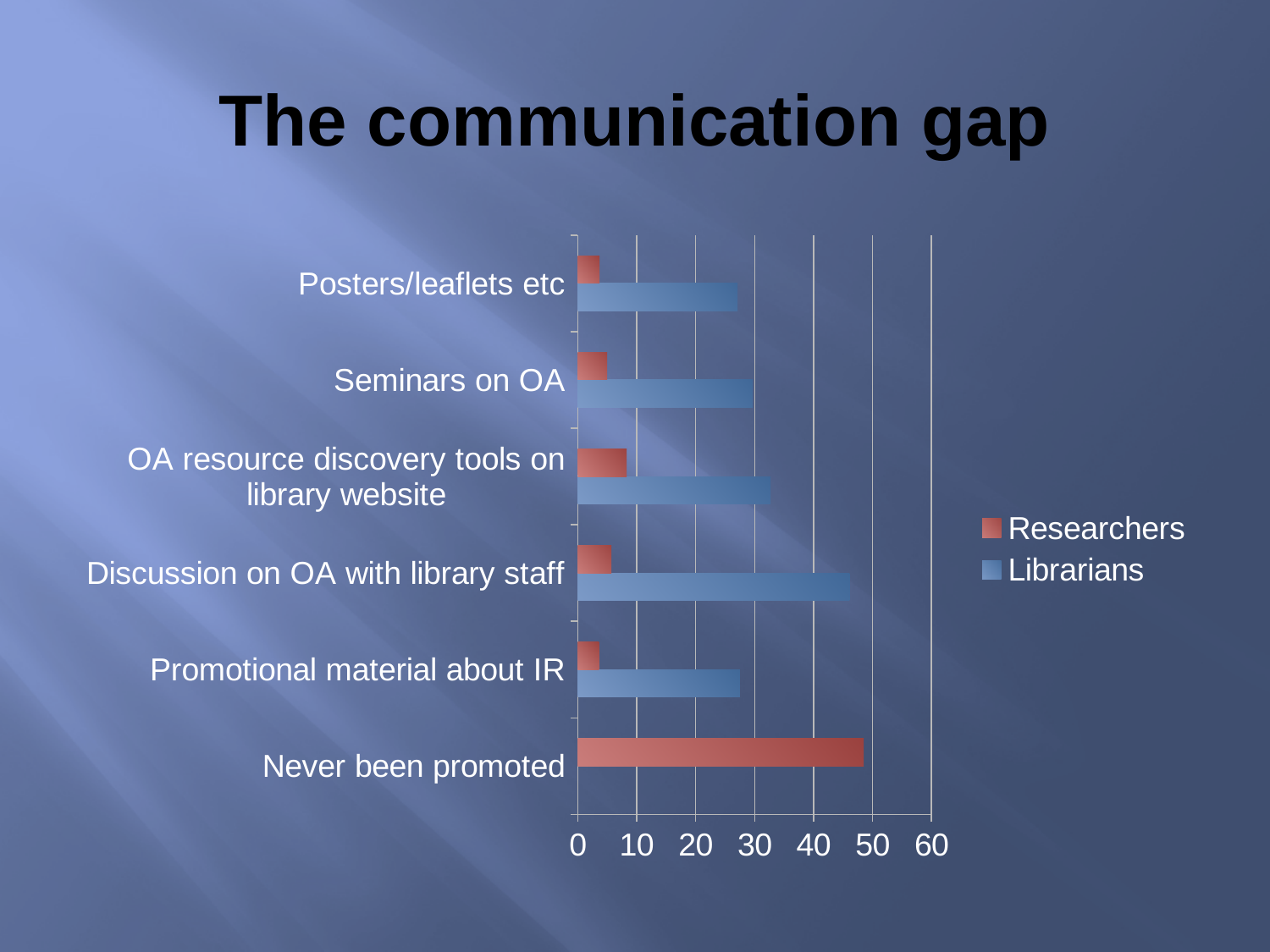
Which series is shown in red in the chart's legend? Researchers How many series does the chart's legend list? 2 What kind of chart is shown on the slide? bar chart Is the Researchers value for Posters/leaflets etc greater or less than 10? less For Discussion on OA with library staff, which series has the larger value, Researchers or Librarians? Librarians Is the Researchers value for Never been promoted greater or less than 40? greater Which category has the highest value for Researchers? Never been promoted Is the Librarians value for Seminars on OA greater or less than 20? greater What is the title of the slide containing the chart? The communication gap How many categories are listed on the chart's vertical axis? 6 Which category has the highest value for Librarians? Discussion on OA with library staff